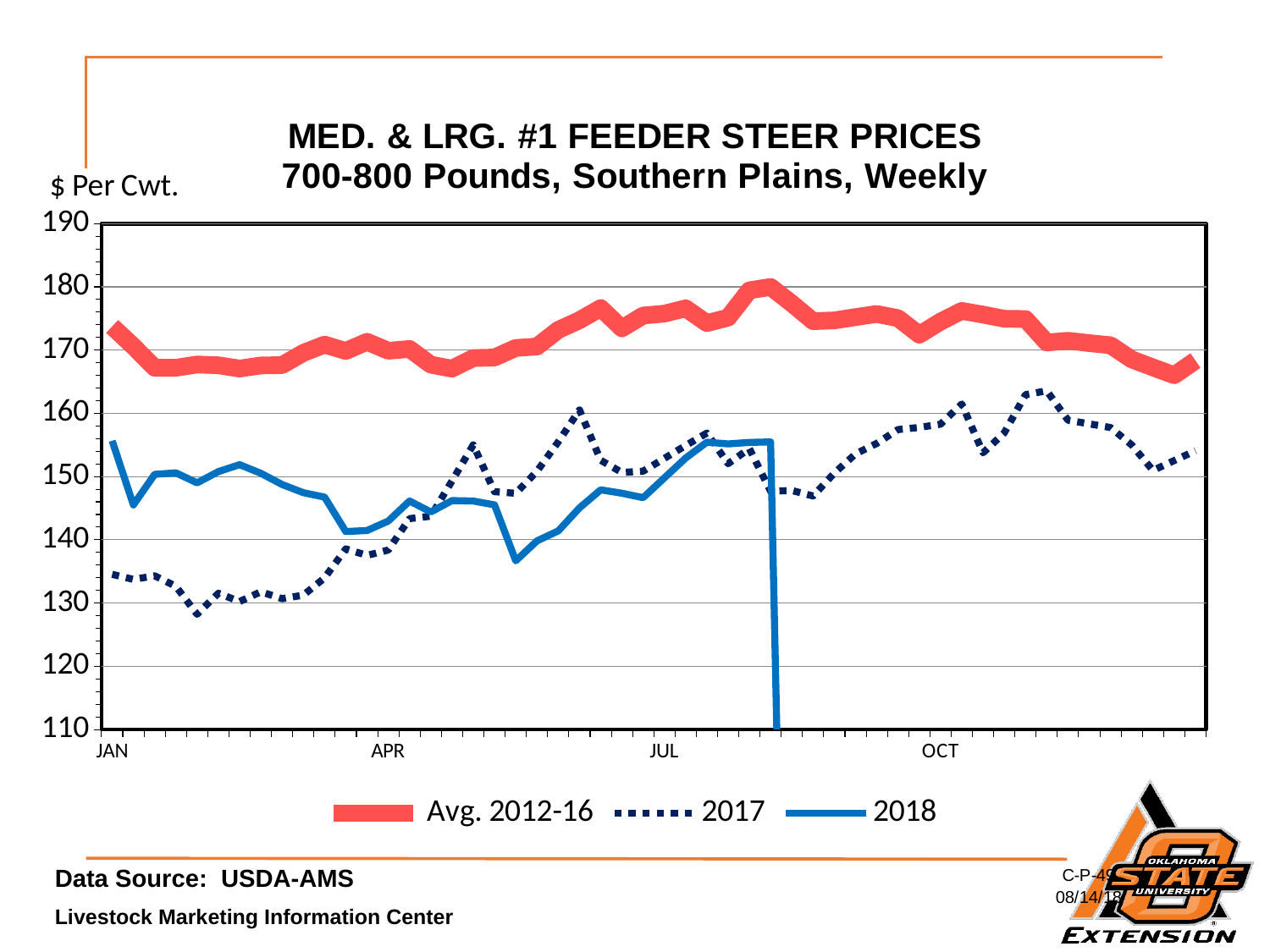
Around OCT, which series is higher, Avg. 2012-16 or 2017? Avg. 2012-16 At the start of JAN, which series has the higher value, 2017 or 2018? 2018 Is the 2017 value at the start of JAN greater or less than 140? less Does the 2017 line generally rise or fall from JAN to OCT? rise Is the 2018 value at the start of JAN greater or less than 150? greater What kind of chart is shown on the slide? line chart Is the Avg. 2012-16 value at the start of JAN greater or less than 170? greater At the start of JAN, which series has the higher value, Avg. 2012-16 or 2017? Avg. 2012-16 How many series does the legend list? 3 What unit label is shown on the vertical axis? $ Per Cwt. What is the title of the chart? MED. & LRG. #1 FEEDER STEER PRICES 700-800 Pounds, Southern Plains, Weekly